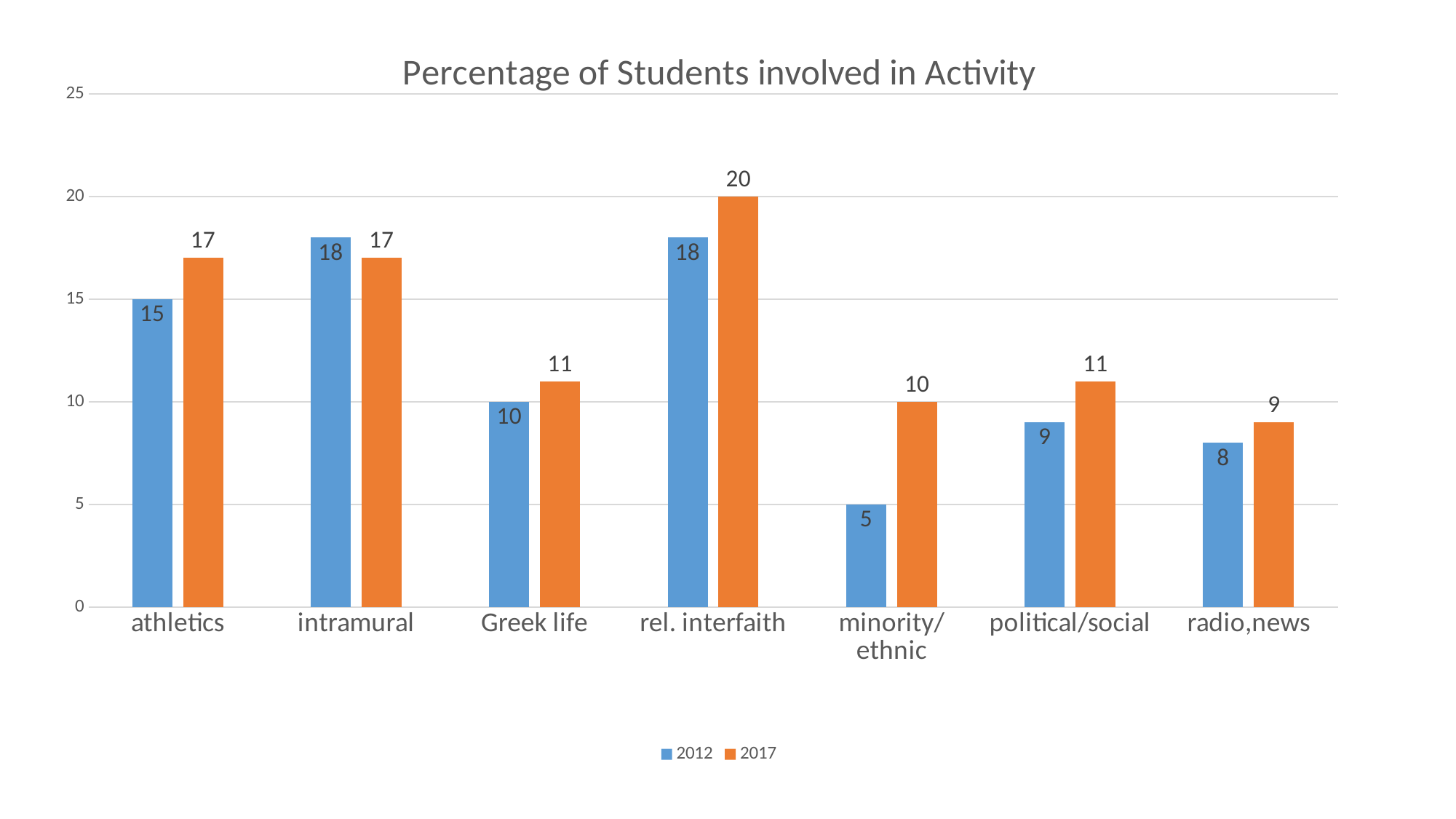
What is the value for minority/ethnic in 2012? 5 How many categories are shown on the x axis? 7 How many series does the legend list? 2 What is the value for athletics in 2012? 15 What kind of chart is shown on the slide? bar chart Which colour represents the 2017 series? orange What is the difference between the 2017 and 2012 values for minority/ethnic? 5 What is the value for rel. interfaith in 2017? 20 Which category has the highest value in the 2017 series? rel. interfaith Which is larger for intramural: the 2012 value or the 2017 value? 2012 Which category has the lowest value in the 2012 series? minority/ethnic What is the title of the chart? Percentage of Students involved in Activity